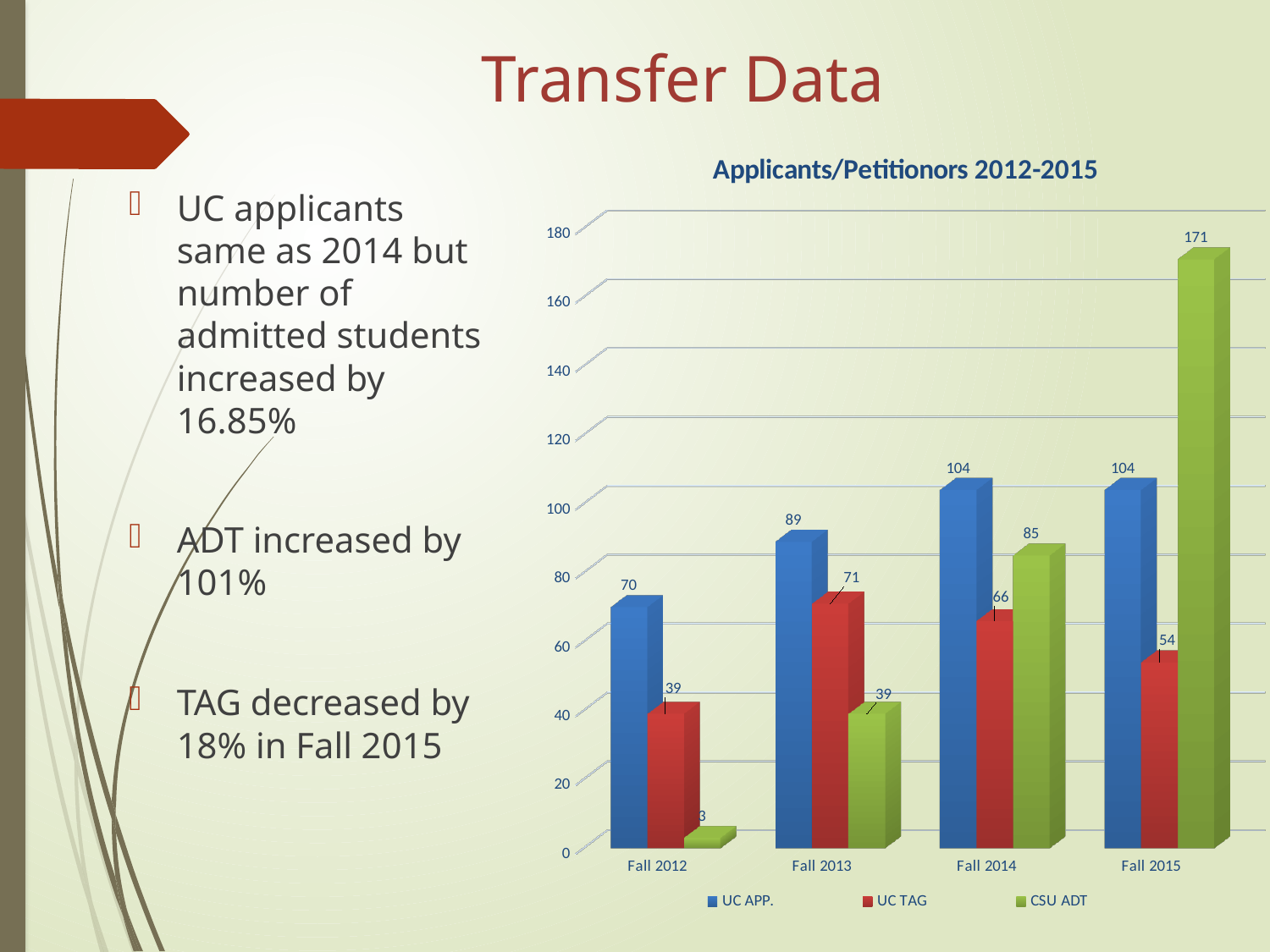
What is the value for UC APP. in Fall 2013? 89 Which is larger in Fall 2014: UC TAG or CSU ADT? CSU ADT Is the value for UC APP. in Fall 2015 greater or less than 100? greater What is the value for CSU ADT in Fall 2015? 171 How many years are shown on the x axis? 4 In which year is the CSU ADT value highest? Fall 2015 What is the value for UC TAG in Fall 2014? 66 In which year is the UC TAG value lowest? Fall 2012 What is the difference between the CSU ADT values for Fall 2015 and Fall 2014? 86 How many series does the legend list? 3 What is the value for UC TAG in Fall 2012? 39 What kind of chart is shown on the slide? bar chart